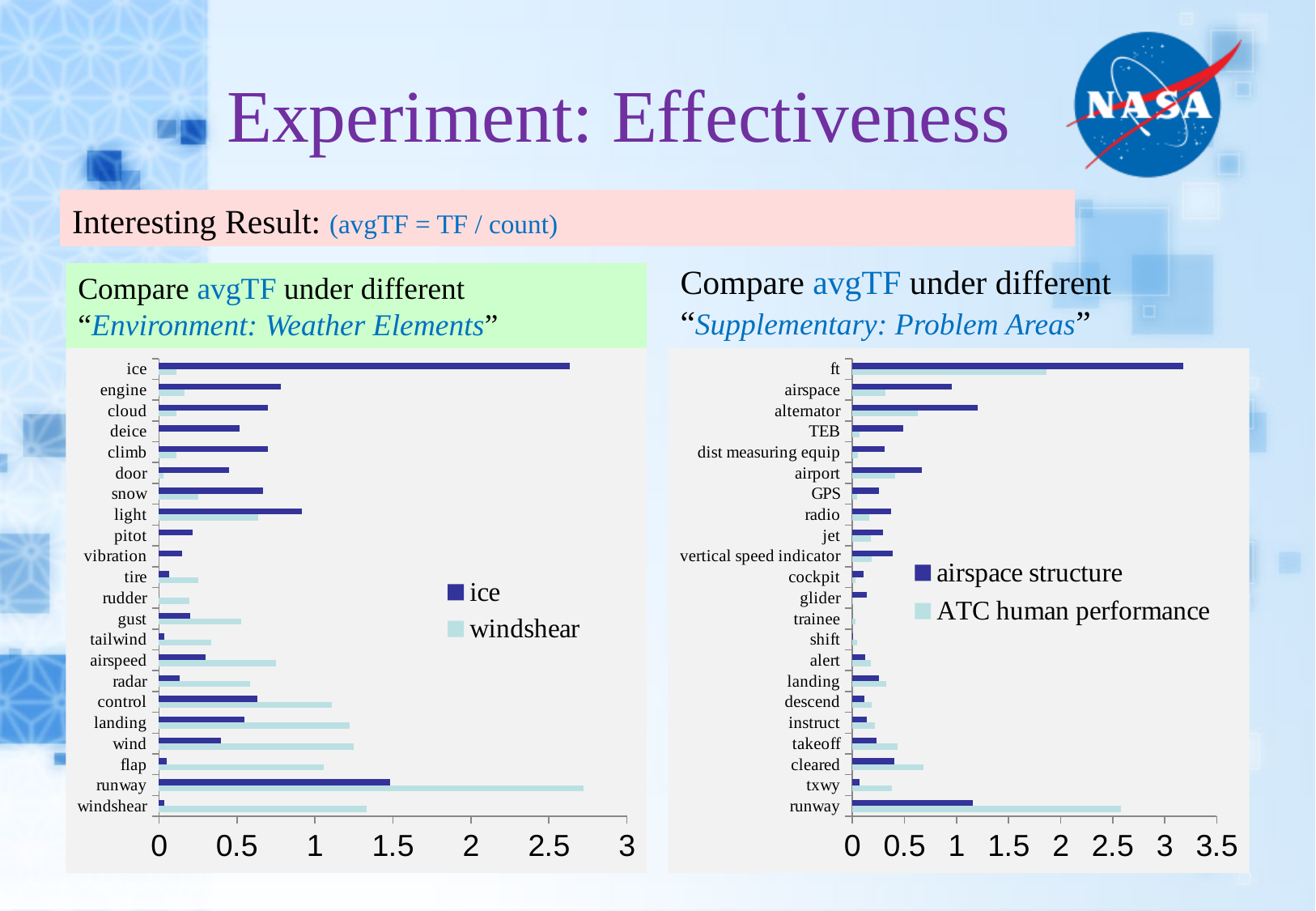
On the left chart, "Environment: Weather Elements", is the ice value for ice greater or less than 2.5? greater On the left chart, "Environment: Weather Elements", for runway, which series has the larger value, ice or windshear? windshear How many categories are plotted on the left chart, "Environment: Weather Elements"? 22 What are the two legend entries on the right chart, "Supplementary: Problem Areas"? airspace structure and ATC human performance How many categories are plotted on the right chart, "Supplementary: Problem Areas"? 22 How many series does the legend of the left chart, "Environment: Weather Elements", list? 2 What kind of chart is the left chart, "Environment: Weather Elements"? bar chart On the left chart, "Environment: Weather Elements", which category has the highest value for the ice series? ice On the right chart, "Supplementary: Problem Areas", is the airspace structure value for ft greater or less than 3? greater On the right chart, "Supplementary: Problem Areas", which category has the highest value for the airspace structure series? ft On the left chart, "Environment: Weather Elements", which category has the highest value for the windshear series? runway On the right chart, "Supplementary: Problem Areas", for runway, which series has the larger value, airspace structure or ATC human performance? ATC human performance